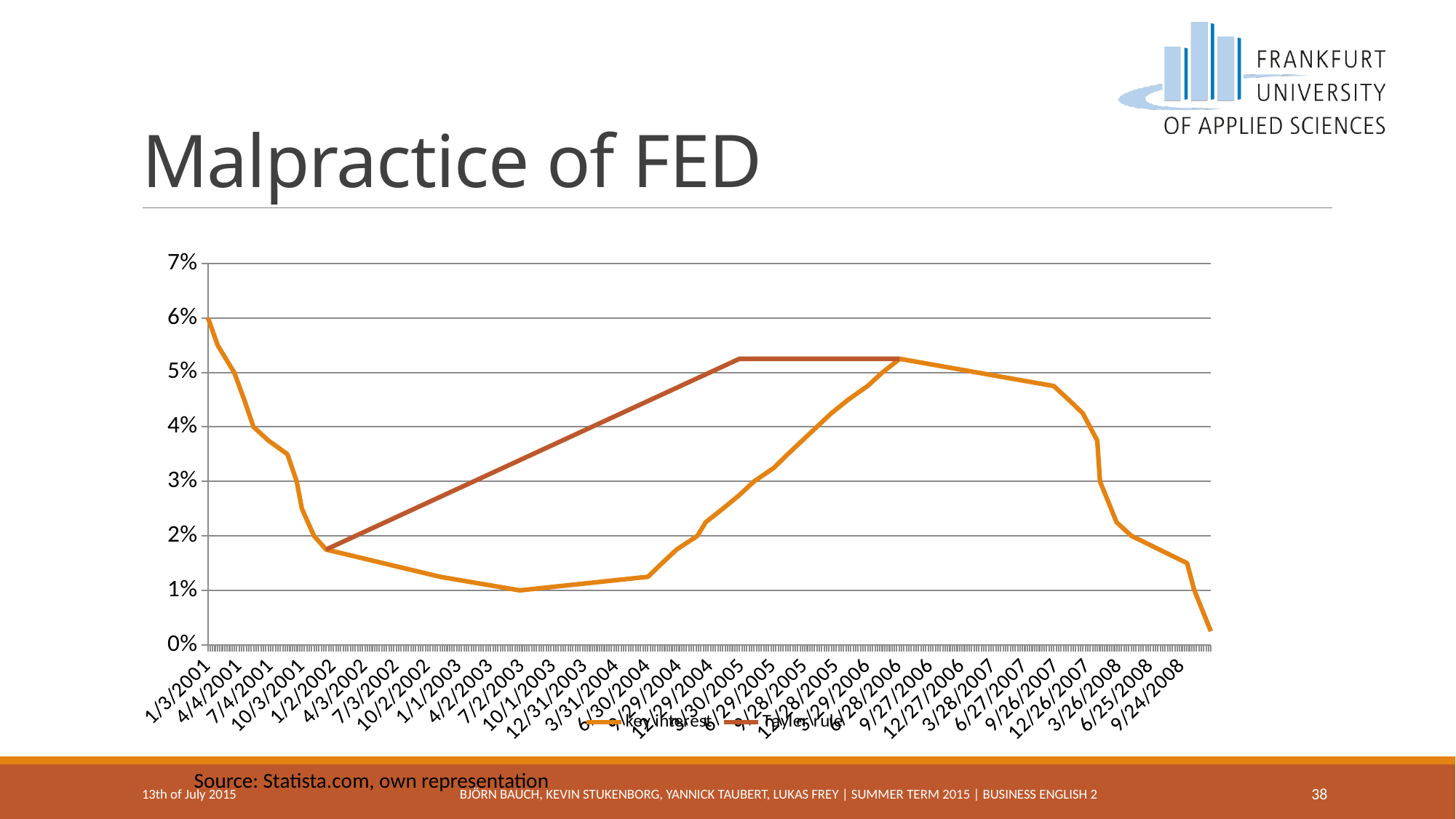
What is the title of the slide containing the chart? Malpractice of FED How many series does the legend list? 2 Is the Taylor rule value at 1/2/2002 greater or less than 2%? less What kind of chart is shown on the slide? Line chart Which series reaches the higher maximum value on the chart? Key interest Is the Key interest value at 9/24/2008 greater or less than 1%? greater Is the Taylor rule value at 10/29/2005 greater or less than 5%? greater What are the two series named in the legend? key interest and Tayler rule Does the Key interest series rise or fall between 1/3/2001 and 7/2/2003? Fall At 1/1/2003, which series has the higher value, Key interest or Taylor rule? Taylor rule